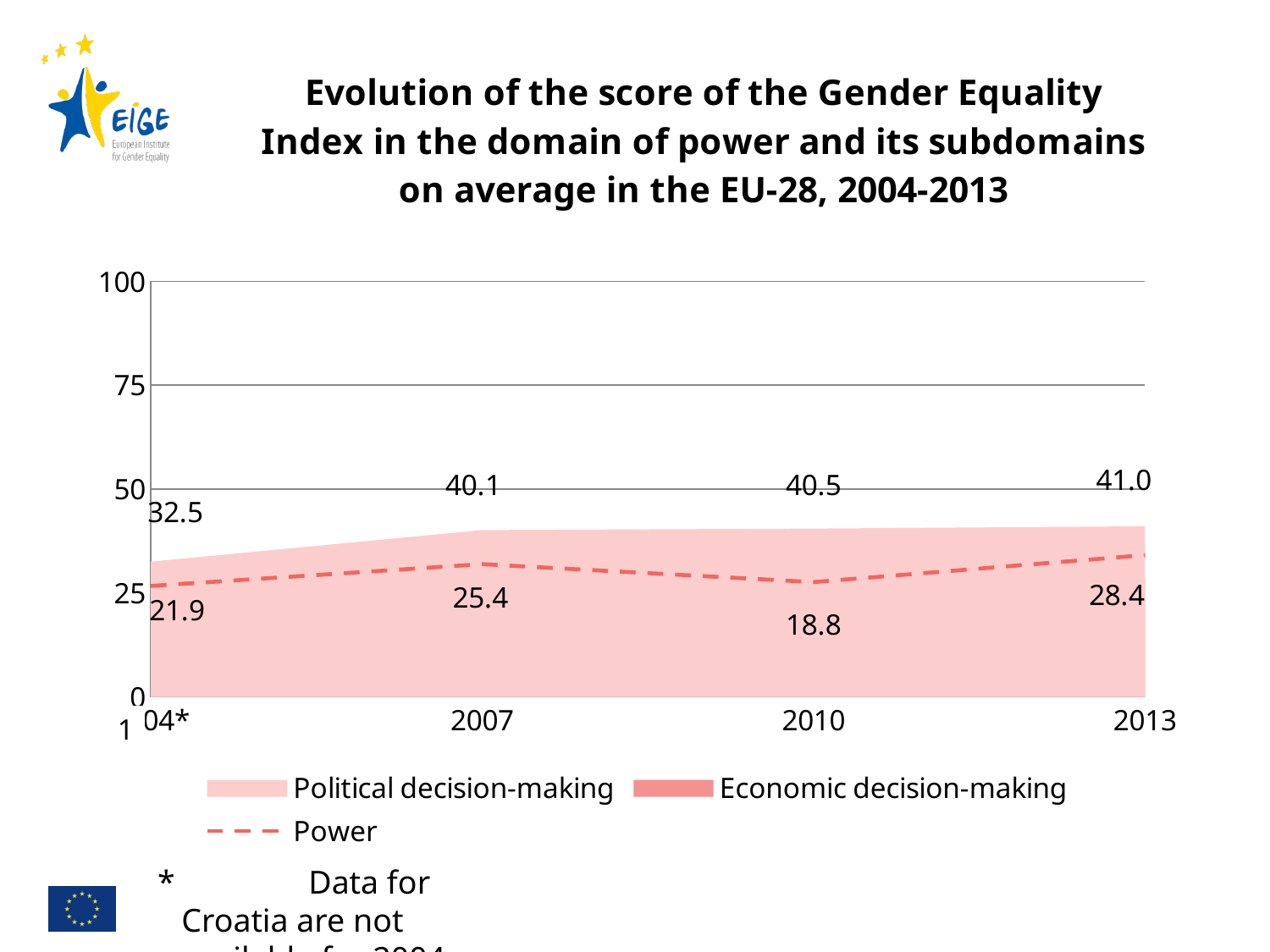
How many time points are shown on the x axis? 4 In which year is Political decision-making highest? 2013 Is the value of the Power line in 2010 greater or less than 50? less Does Political decision-making rise or fall from 04* to 2013? rise How many series does the legend list? 3 What is the value for Political decision-making in 04*? 32.5 Which is larger, Economic decision-making in 2007 or in 2013? 2013 What is the difference between Political decision-making and Economic decision-making in 2013? 12.6 Which series is drawn as a dashed line? Power In which year is Economic decision-making lowest? 2010 What is the value for Political decision-making in 2013? 41.0 What is the value for Economic decision-making in 2010? 18.8